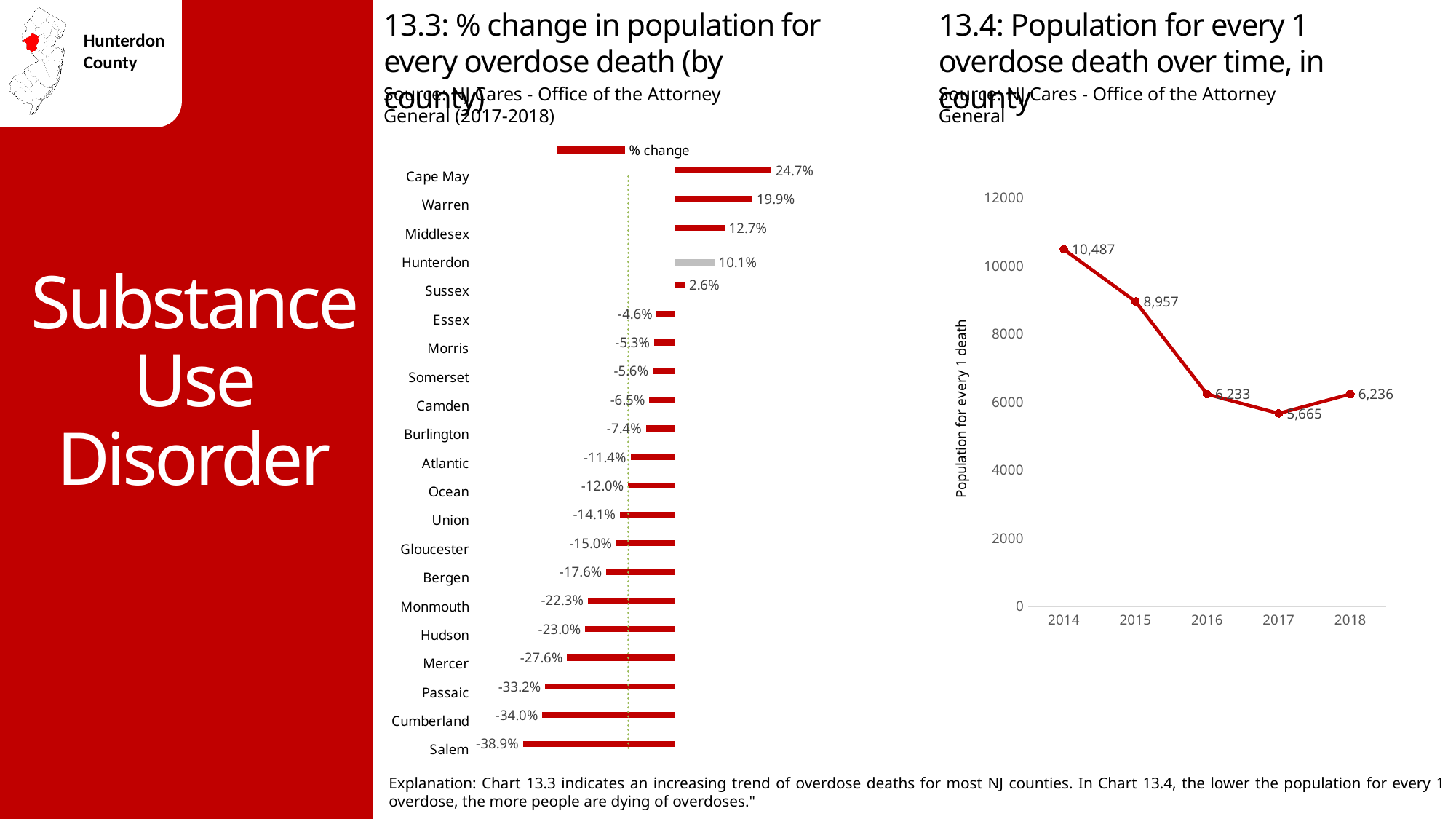
In chart 13.3, what is the % change for Salem? -38.9% In chart 13.3, what is the % change for Hunterdon? 10.1% In chart 13.4, which year has the lowest population for every 1 overdose death? 2017 In chart 13.3, which county has the lowest % change? Salem In chart 13.4, does the value rise or fall from 2014 to 2017? Fall In chart 13.3, how many counties are shown? 21 In chart 13.3, which county has the highest % change? Cape May What kind of chart is chart 13.3? Bar chart In chart 13.4, what is the difference between the 2014 and 2017 values? 4,822 In chart 13.3, which has a larger % change, Warren or Middlesex? Warren In chart 13.4, how many years are plotted? 5 In chart 13.4, what is the population for every 1 overdose death in 2014? 10,487